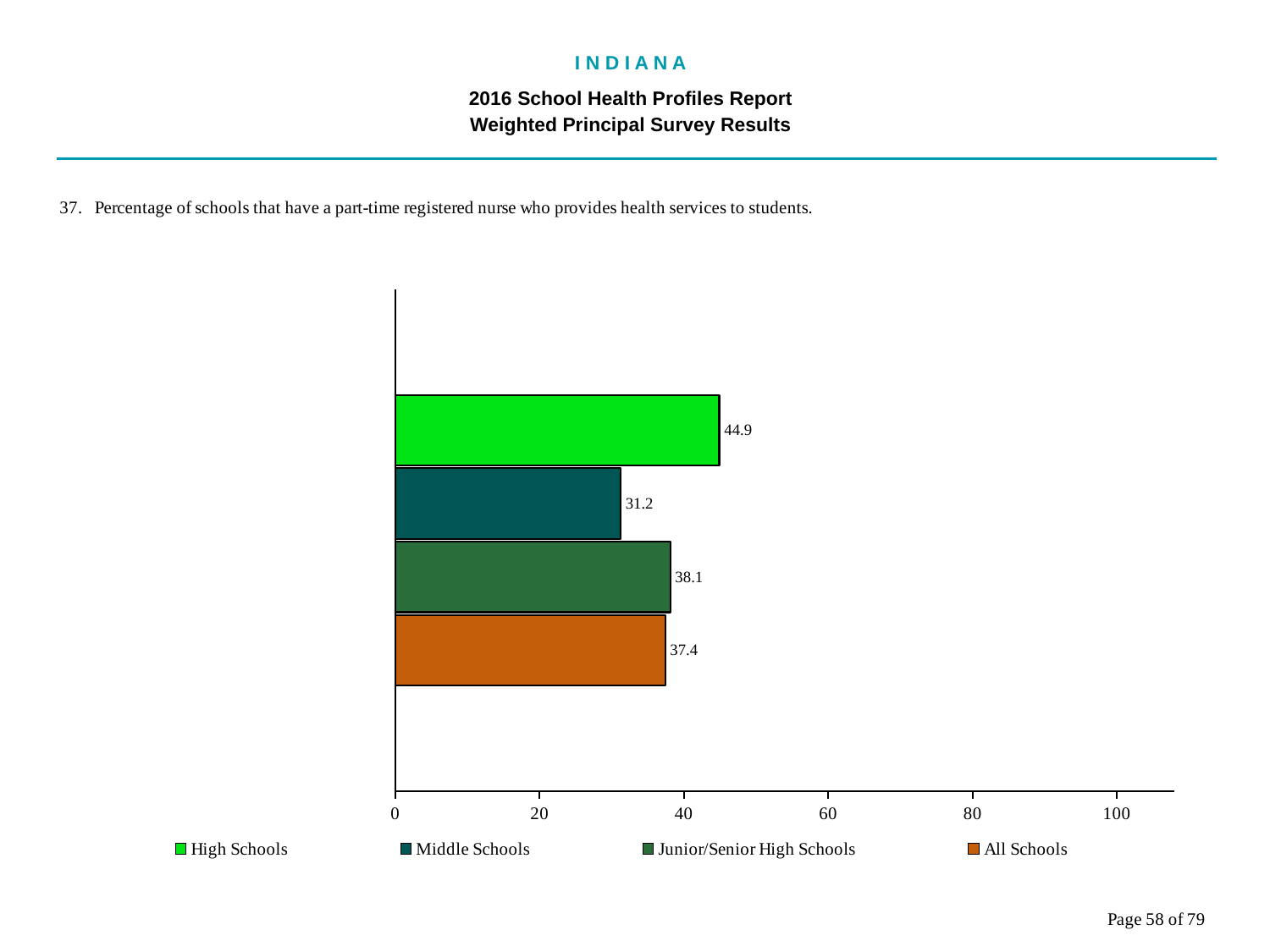
How many bars are shown in the chart? 4 What is the value for All Schools? 37.4 What is the value for High Schools? 44.9 What is the value for Junior/Senior High Schools? 38.1 Which is larger, the value for High Schools or the value for Junior/Senior High Schools? High Schools What kind of chart is shown on the slide? bar chart Is the value for Middle Schools greater or less than 40? less How many entries does the legend list? 4 Which school type has the lowest value? Middle Schools Which school type has the highest value? High Schools What is the difference between the values for High Schools and Middle Schools? 13.7 What is the value for Middle Schools? 31.2